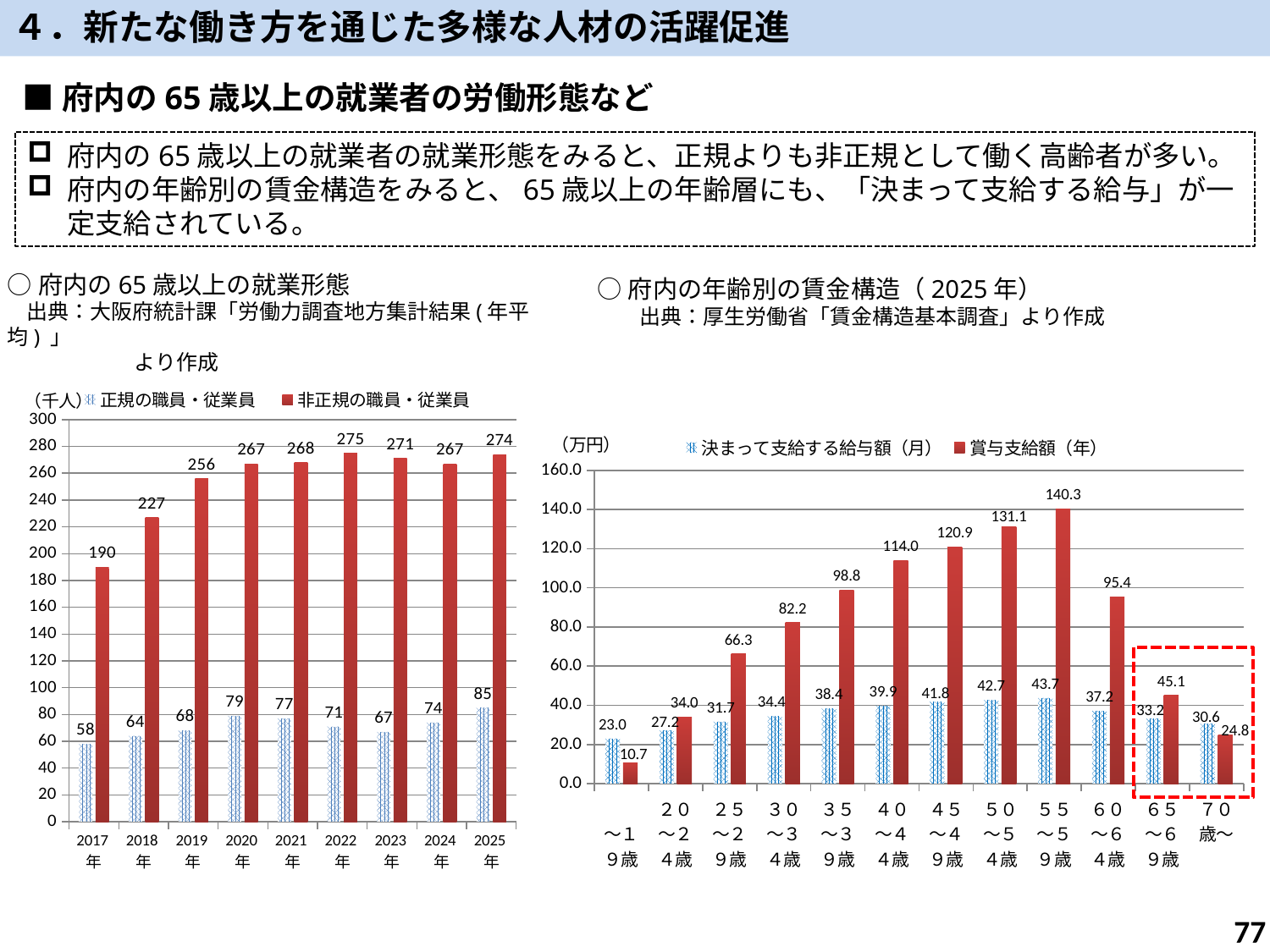
In the left chart (府内の65歳以上の就業形態), which year has the highest value for 正規の職員・従業員? 2025年 In the left chart (府内の65歳以上の就業形態), what is the value for 正規の職員・従業員 in 2017年? 58 In the right chart (府内の年齢別の賃金構造), how many series does the legend list? 2 In the right chart (府内の年齢別の賃金構造), what is the value of 賞与支給額（年） for 55～59歳? 140.3 In the right chart (府内の年齢別の賃金構造), what is the value of 決まって支給する給与額（月） for 65～69歳? 33.2 In the right chart (府内の年齢別の賃金構造), which is larger for 70歳～: 決まって支給する給与額（月） or 賞与支給額（年）? 決まって支給する給与額（月） In the left chart (府内の65歳以上の就業形態), how many years are shown on the x axis? 9 In the left chart (府内の65歳以上の就業形態), which year has the lowest value for 非正規の職員・従業員? 2017年 What kind of chart is the right chart (府内の年齢別の賃金構造)? Bar chart In the left chart (府内の65歳以上の就業形態), what is the value for 非正規の職員・従業員 in 2022年? 275 In the left chart (府内の65歳以上の就業形態), what is the difference between 非正規の職員・従業員 and 正規の職員・従業員 in 2025年? 189 In the right chart (府内の年齢別の賃金構造), which age group has the lowest 賞与支給額（年）? ～19歳